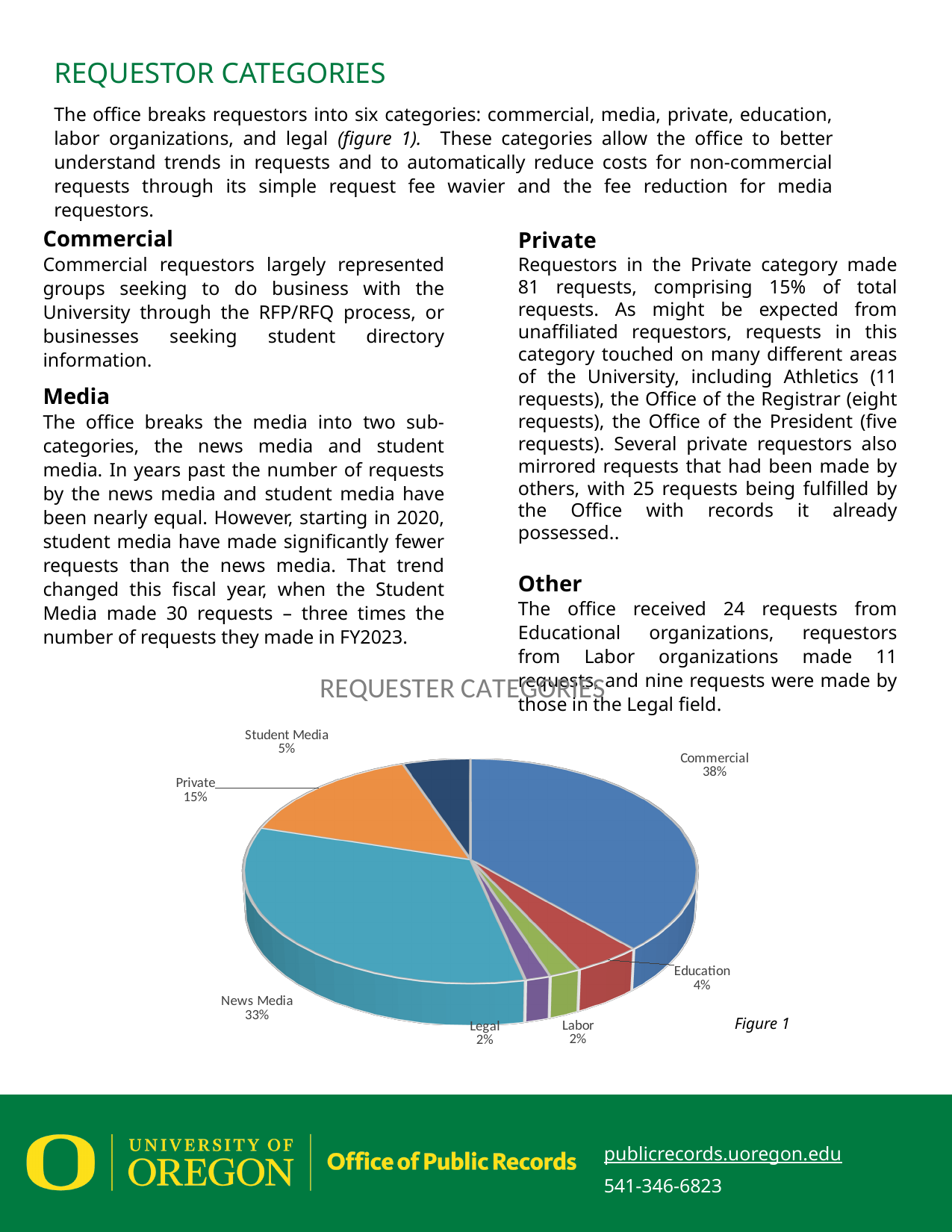
What is the title of the chart? REQUESTER CATEGORIES What is the combined share of Labor and Legal? 4% What is the difference in percentage points between Commercial and News Media? 5 What share of the pie does Student Media represent? 5% What share of the pie does Private represent? 15% Which is larger, the Private slice or the Student Media slice? Private What kind of chart is shown on the slide? pie chart What share of the pie does Commercial represent? 38% What share of the pie does News Media represent? 33% Which category has the largest slice of the pie? Commercial What share of the pie does Education represent? 4% How many slices does the pie chart have? 7